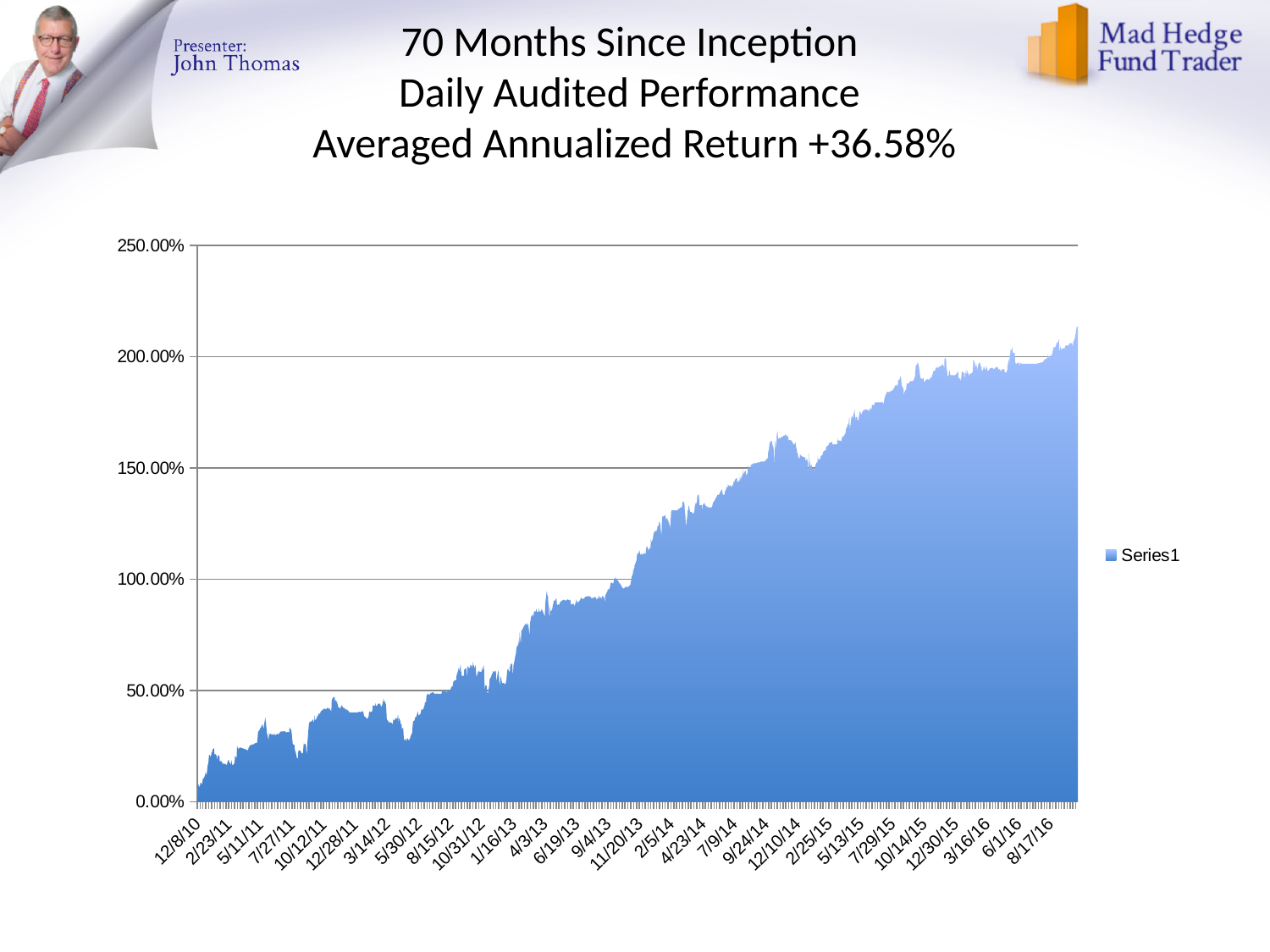
What is the name of the series shown in the legend? Series1 What averaged annualized return is stated in the slide title? +36.58% Is the value at 5/13/15 greater or less than 150.00%? greater Is the value at 3/16/16 greater or less than 150.00%? greater Is the value at 5/11/11 greater or less than 50.00%? less What kind of chart is shown on the slide? area chart Do the values generally rise or fall from 12/8/10 to 8/17/16? rise Which is larger, the value at 12/10/14 or the value at 5/30/12? 12/10/14 How many series does the legend list? 1